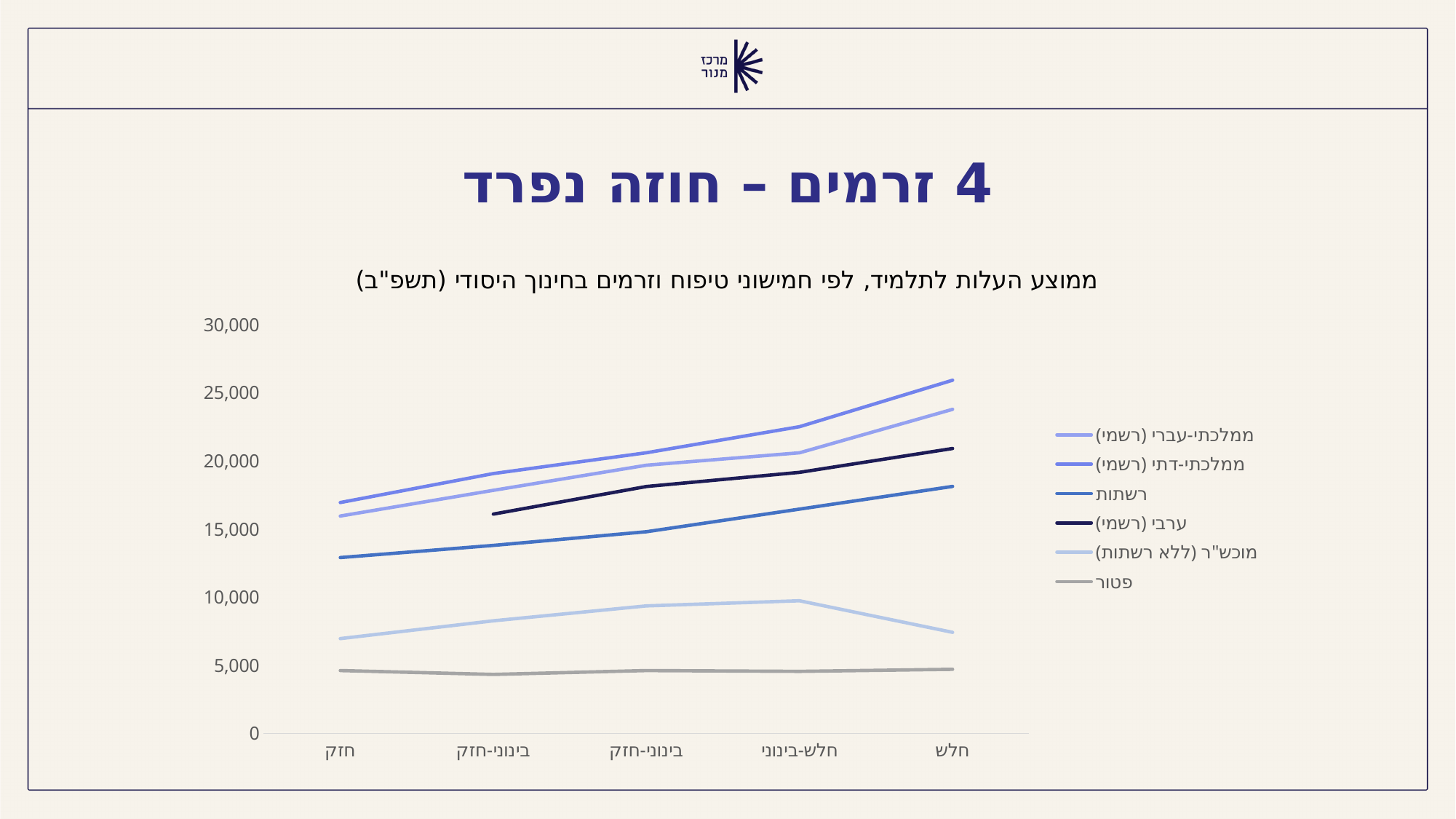
How many series does the legend list? 6 Is the value for רשתות at חלש greater or less than 15,000? greater Which series has the lowest values across all categories? פטור Do the values for ממלכתי-דתי (רשמי) rise or fall from חזק to חלש? rise At the חלש category, which is larger: ערבי (רשמי) or מוכש"ר (ללא רשתות)? ערבי (רשמי) What is the title of the chart? ממוצע העלות לתלמיד, לפי חמישוני טיפוח וזרמים בחינוך היסודי (תשפ"ב) How many categories are shown along the x axis? 5 Is the value for ממלכתי-דתי (רשמי) at חלש greater or less than 25,000? greater Which series has the highest value at the חלש category? ממלכתי-דתי (רשמי) Is the value for מוכש"ר (ללא רשתות) at חזק greater or less than 10,000? less At the חזק category, which is larger: ממלכתי-דתי (רשמי) or רשתות? ממלכתי-דתי (רשמי) What kind of chart is shown on the slide? line chart